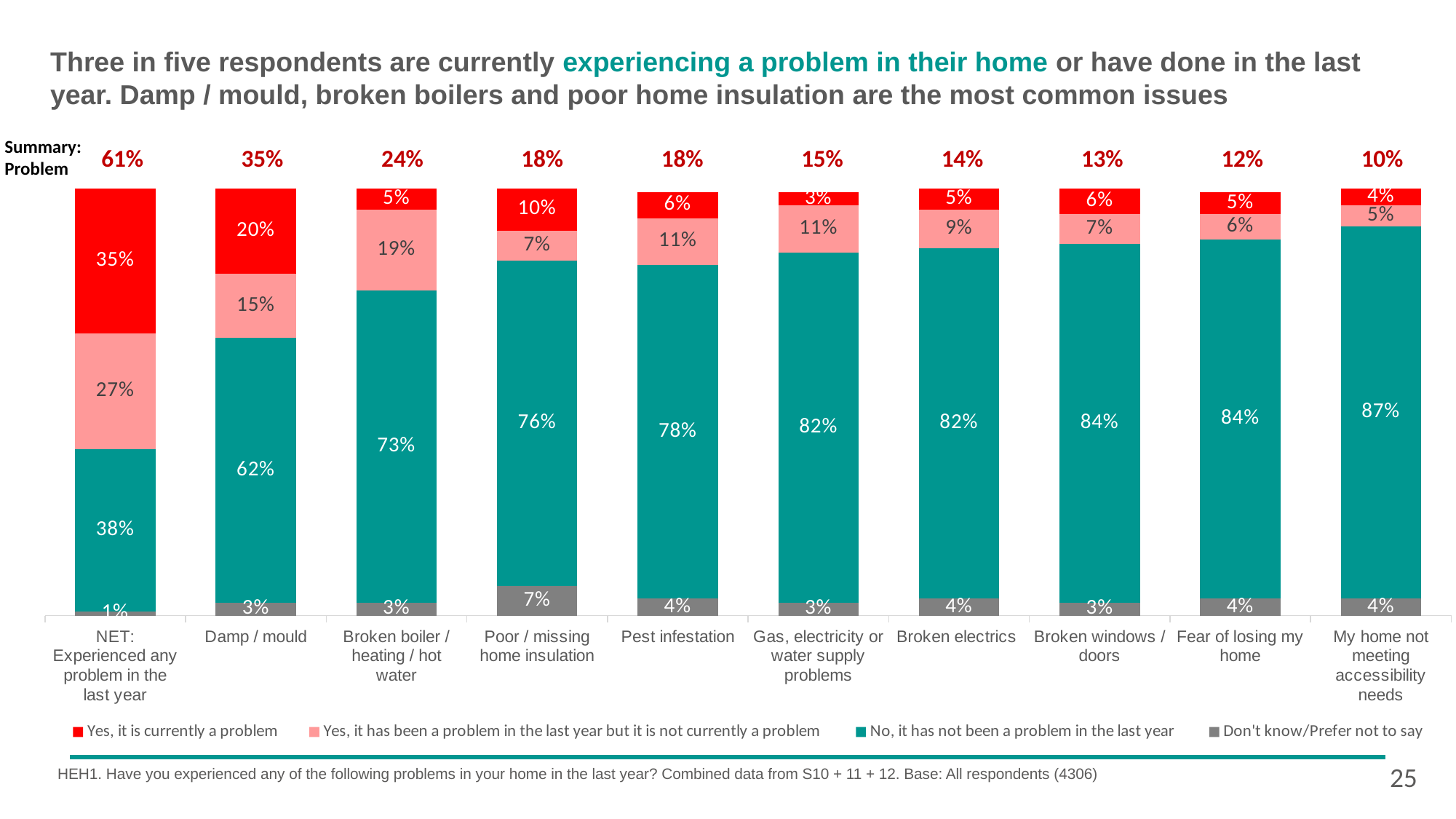
Excluding the NET bar, which category has the highest Summary: Problem value? Damp / mould Do the Summary: Problem values rise or fall moving from left to right across the categories? Fall How many series does the legend list? 4 What is the Summary: Problem value for Broken boiler / heating / hot water? 24% What is the 'No, it has not been a problem in the last year' value for Pest infestation? 78% What percentage of respondents say damp / mould is currently a problem? 20% What is the difference between the 'No, it has not been a problem in the last year' values for My home not meeting accessibility needs and Damp / mould? 25% Which has a larger 'Yes, it is currently a problem' value: Poor / missing home insulation or Pest infestation? Poor / missing home insulation How many categories are shown along the x axis of the chart? 10 What kind of chart is shown on the slide? Stacked bar chart Which category has the lowest Summary: Problem value? My home not meeting accessibility needs What is the combined share of respondents for Damp / mould who say it is currently a problem or has been a problem in the last year? 35%